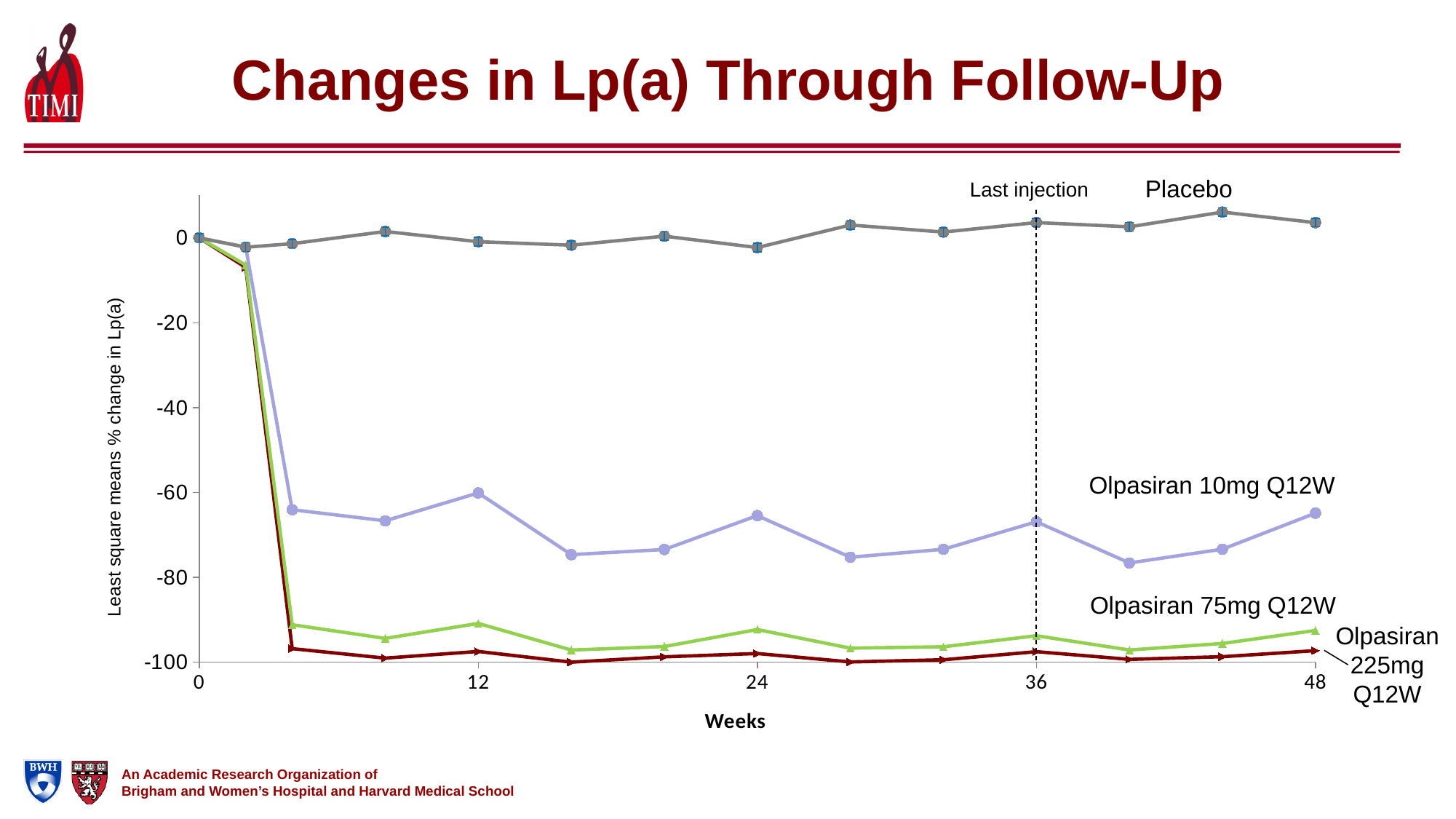
Which series has the highest values at week 48? Placebo At week 24, which is lower: Olpasiran 75mg Q12W or Olpasiran 10mg Q12W? Olpasiran 75mg Q12W Is the value for Placebo at week 48 greater or less than -20? greater Is the value for Olpasiran 75mg Q12W at week 48 greater or less than -80? less Is the value for Olpasiran 10mg Q12W at week 48 greater or less than -60? less What is the title of the chart on the slide? Changes in Lp(a) Through Follow-Up Does the Olpasiran 10mg Q12W line rise or fall between week 0 and week 4? Fall What kind of chart is shown on the slide? Line chart At which week is the dashed 'Last injection' line drawn? 36 How many series are plotted on the chart? 4 Which series has the lowest values at week 48? Olpasiran 225mg Q12W At week 48, which is higher: Placebo or Olpasiran 10mg Q12W? Placebo